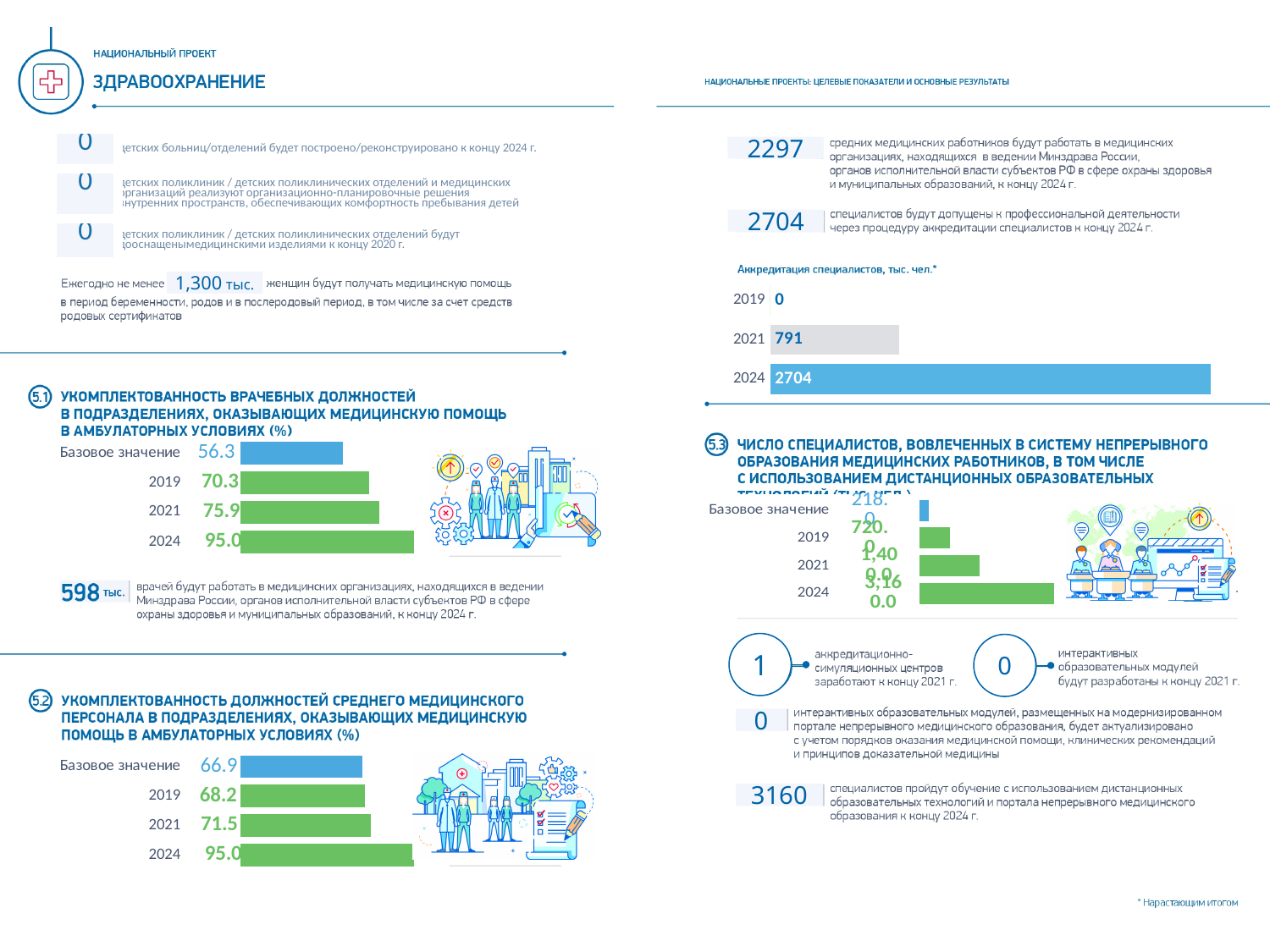
In chart 5.1 (Укомплектованность врачебных должностей), what is the value for Базовое значение? 56.3 In chart 5.1 (Укомплектованность врачебных должностей), what is the difference between the 2024 value and the 2019 value? 24.7 In chart 5.2 (Укомплектованность должностей среднего медицинского персонала), which is larger, the value for 2019 or the value for 2021? 2021 In the chart titled 'Аккредитация специалистов, тыс. чел.', what is the value for 2021? 791 In the chart titled 'Аккредитация специалистов, тыс. чел.', which year has the highest value? 2024 In chart 5.2 (Укомплектованность должностей среднего медицинского персонала), how many bars are plotted? 4 In chart 5.1 (Укомплектованность врачебных должностей), what is the value for 2024? 95.0 In chart 5.1 (Укомплектованность врачебных должностей), do the values rise or fall from Базовое значение to 2024? rise In chart 5.2 (Укомплектованность должностей среднего медицинского персонала), what is the value for 2021? 71.5 In chart 5.2 (Укомплектованность должностей среднего медицинского персонала), which category has the lowest value? Базовое значение In the chart titled 'Аккредитация специалистов, тыс. чел.', what is the difference between the 2024 value and the 2021 value? 1913 What type of chart is chart 5.3 (Число специалистов, вовлеченных в систему непрерывного образования)? bar chart